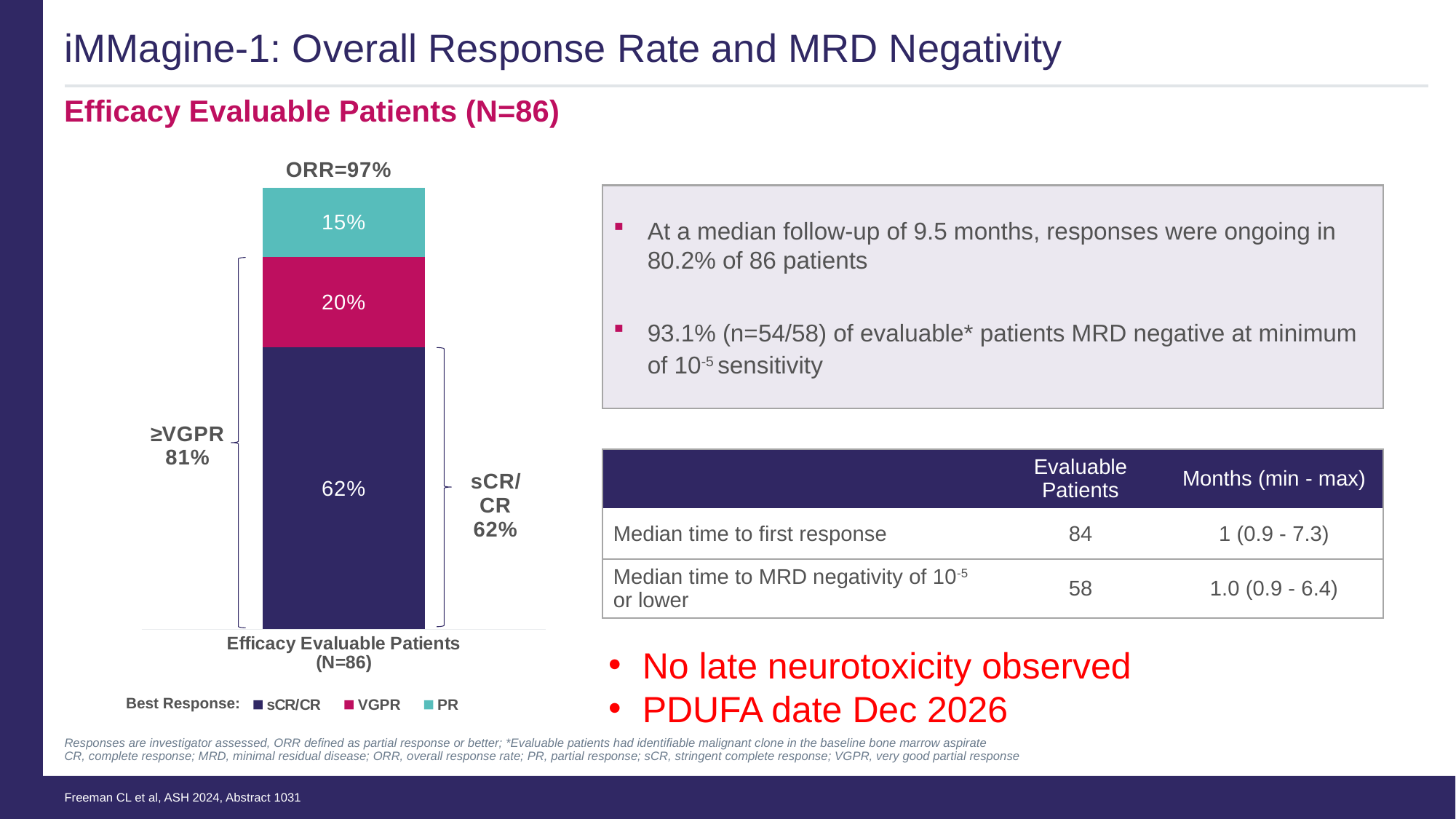
Which best response category has the smallest share of the stacked bar? PR Which is larger, the VGPR percentage or the PR percentage? VGPR What is the ≥VGPR rate indicated by the bracket on the chart? 81% What kind of chart is shown on the slide? Stacked bar chart What is the x-axis category label of the bar? Efficacy Evaluable Patients (N=86) What percentage of efficacy evaluable patients achieved sCR/CR as best response? 62% What is the difference between the sCR/CR percentage and the VGPR percentage? 42% What percentage of efficacy evaluable patients achieved PR as best response? 15% What is the overall response rate (ORR) shown above the bar? 97% Which best response category has the largest share of the stacked bar? sCR/CR How many best response categories does the legend list? 3 What percentage of efficacy evaluable patients achieved VGPR as best response? 20%